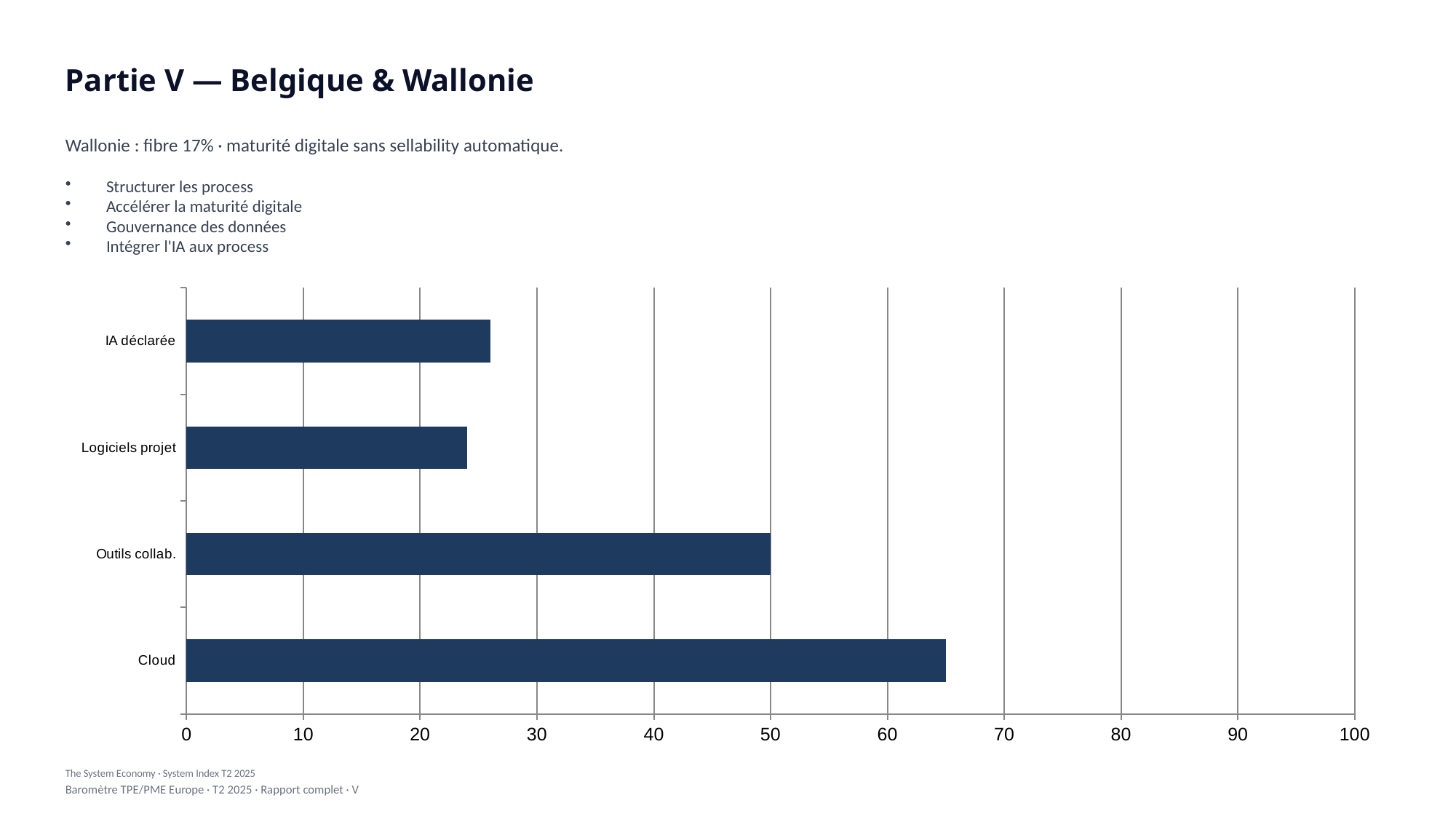
Is the value for Cloud greater or less than 70? less What is the maximum value shown on the horizontal axis of the chart? 100 Is the value for IA déclarée greater or less than 30? less Is the value for Cloud greater or less than 60? greater Which category has the highest value in the bar chart? Cloud Which is larger, the value for Outils collab. or the value for IA déclarée? Outils collab. What kind of chart is shown on the slide? bar chart What colour are the bars in the chart? dark navy blue How many categories does the bar chart show? 4 Which is larger, the value for Cloud or the value for Outils collab.? Cloud What is the value for Outils collab.? 50